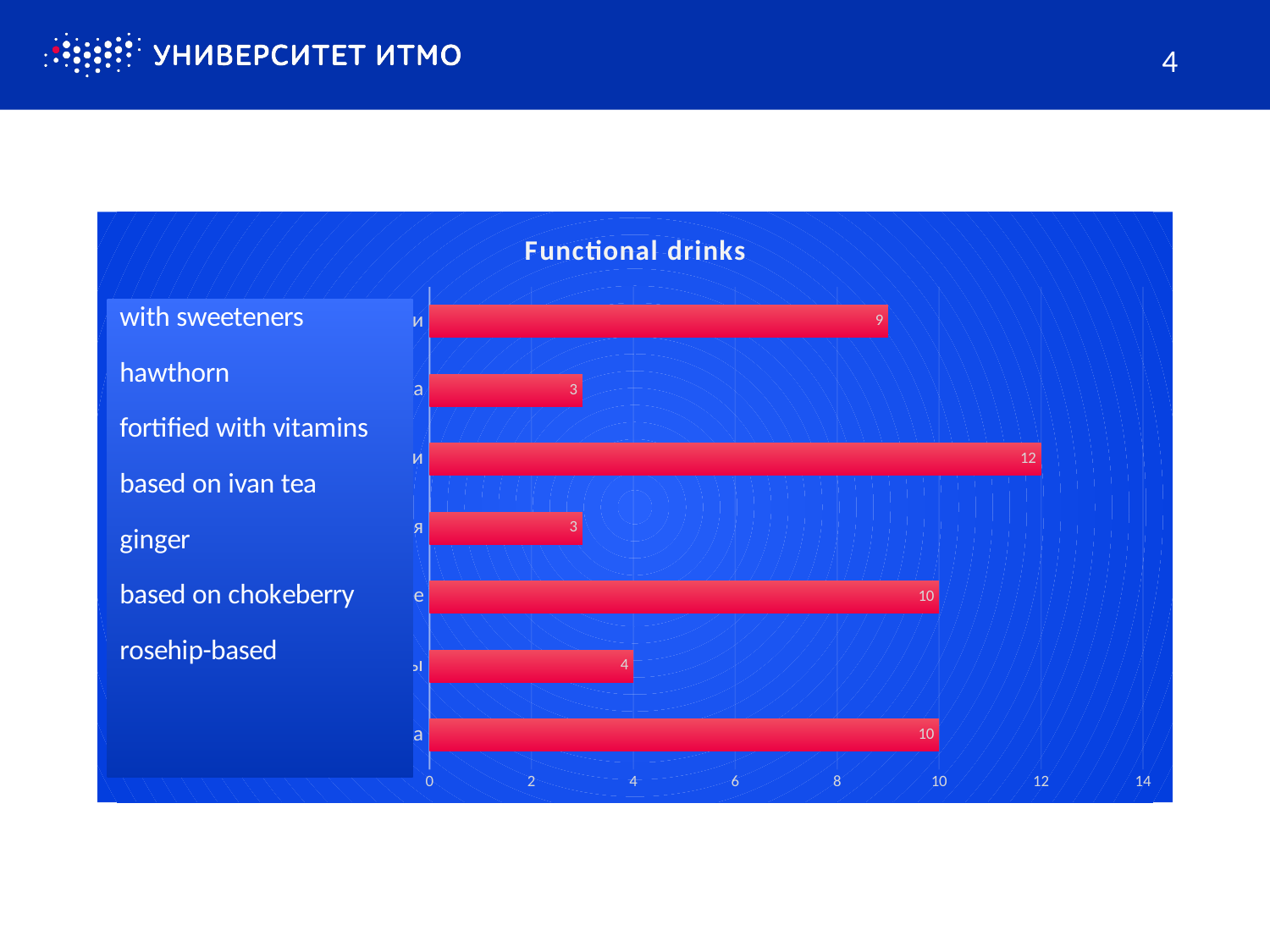
How many bars have a value of 3? 2 How many bars does the chart have? 7 What kind of chart is shown on the slide? bar chart What is the lowest value shown on any bar in the chart? 3 What is the title of the chart? Functional drinks What is the highest value shown on any bar in the chart? 12 What colour are the bars in the chart? red What is the value for 'with sweeteners'? 9 Is the longest bar's value greater or less than 10? greater Is the value for 'with sweeteners' greater or less than 10? less What is the difference between the highest bar value and the lowest bar value? 9 How many bars have a value of 10? 2